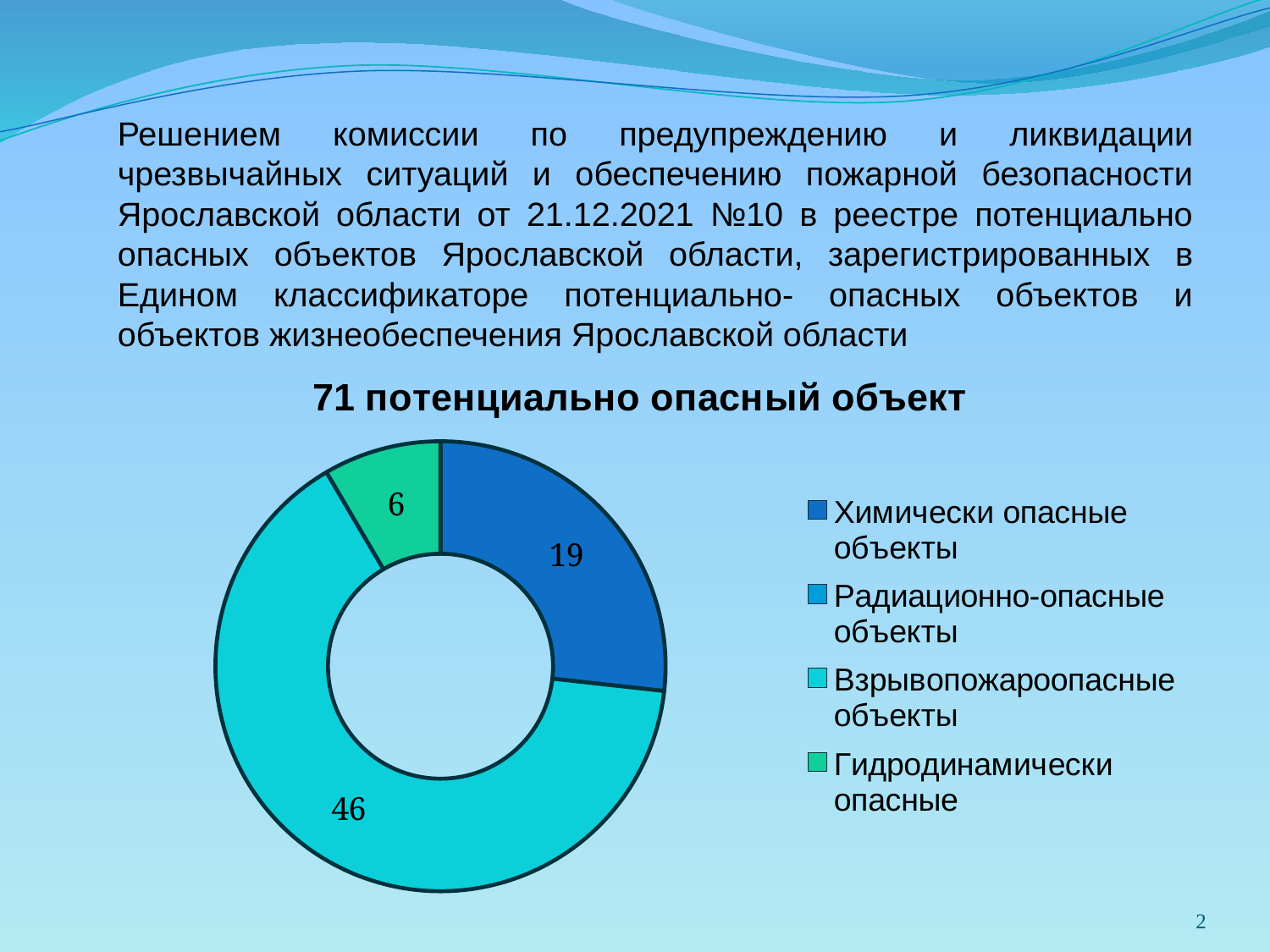
What kind of chart is shown on the slide? doughnut chart What is the title of the chart? 71 потенциально опасный объект Which labelled category has the smallest value? Гидродинамически опасные What is the difference between the values for Взрывопожароопасные объекты and Химически опасные объекты? 27 What is the difference between the values for Химически опасные объекты and Гидродинамически опасные? 13 Which category has the largest value? Взрывопожароопасные объекты What is the value for Взрывопожароопасные объекты? 46 What is the value for Химически опасные объекты? 19 How many slices with data labels are shown in the chart? 3 How many entries does the legend list? 4 What is the value for Гидродинамически опасные? 6 Which is larger, the value for Химически опасные объекты or the value for Гидродинамически опасные? Химически опасные объекты